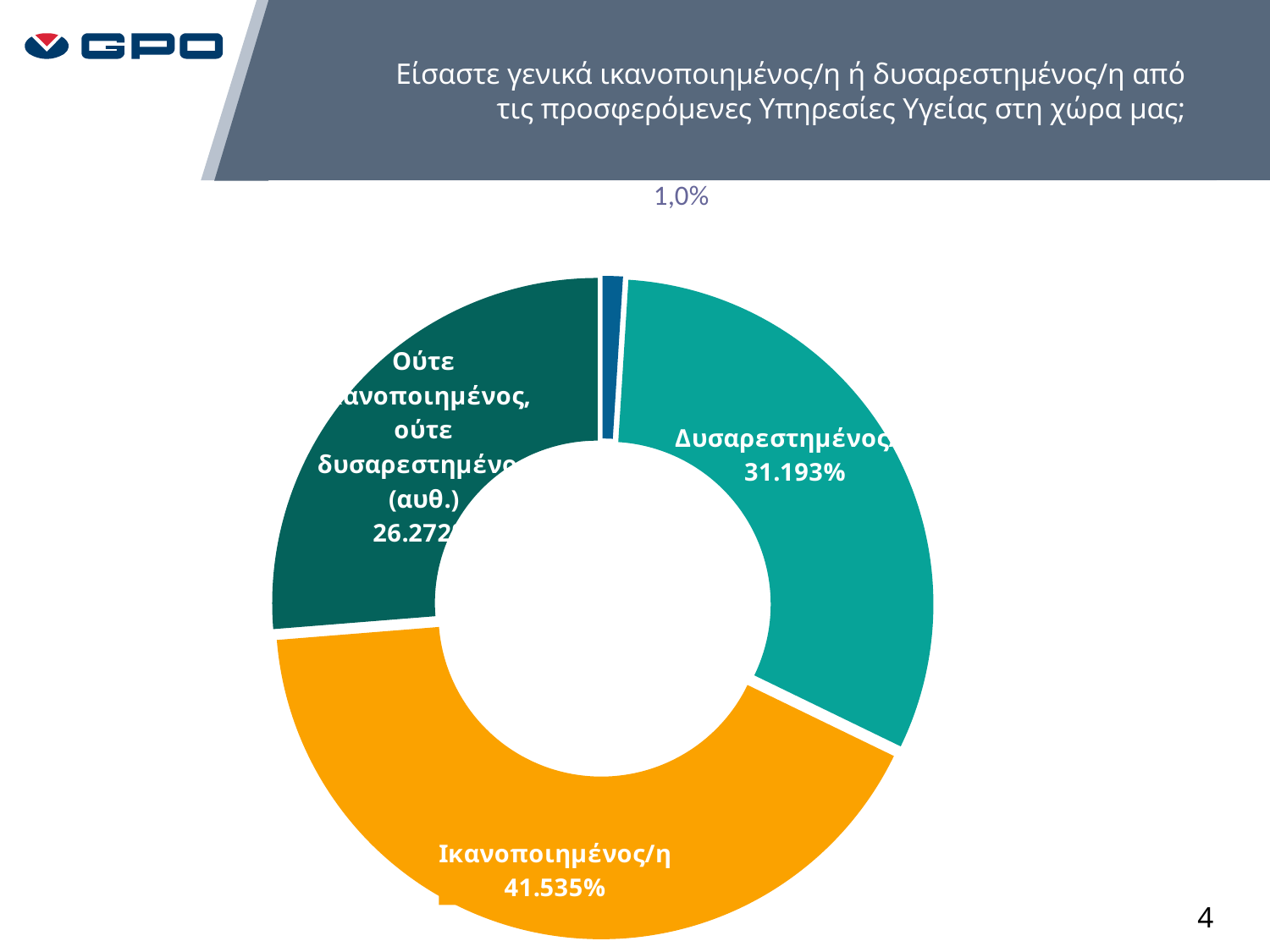
Which is larger, the share for Ικανοποιημένος/η or the share for Δυσαρεστημένος? Ικανοποιημένος/η What kind of chart is shown on the slide? Doughnut (pie) chart Which is larger, the share for Δυσαρεστημένος or the share for Ούτε ικανοποιημένος, ούτε δυσαρεστημένος (αυθ.)? Δυσαρεστημένος What is the difference in percentage points between Ικανοποιημένος/η and Δυσαρεστημένος? 10.342 What colour is the Ικανοποιημένος/η slice? Orange How many slices does the chart have? 4 Which response category has the largest share of the chart? Ικανοποιημένος/η What value is shown for the small blue slice at the top of the chart? 1,0% What percentage of respondents answered Δυσαρεστημένος? 31.193% What percentage of respondents answered Ικανοποιημένος/η? 41.535% What question does the chart title ask? Είσαστε γενικά ικανοποιημένος/η ή δυσαρεστημένος/η από τις προσφερόμενες Υπηρεσίες Υγείας στη χώρα μας; Is the share for Ικανοποιημένος/η greater or less than 50%? less